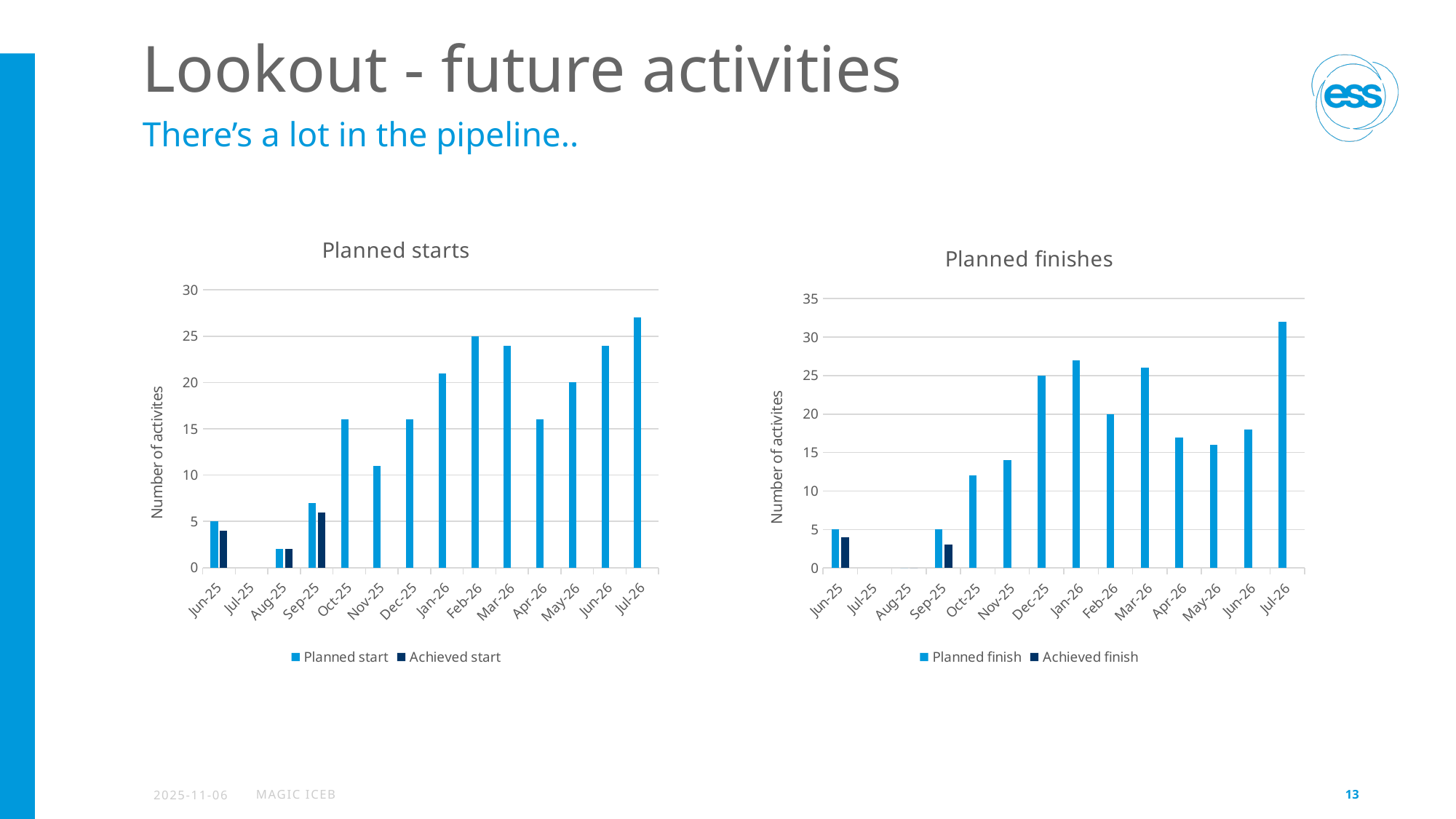
In the Planned finishes chart, which is larger, the Planned finish value for Jan-26 or for Apr-26? Jan-26 In the Planned finishes chart, which month has the highest Planned finish value? Jul-26 In the Planned finishes chart, is the Planned finish value for Jul-26 greater or less than 30? greater In the Planned starts chart, which month has the highest Planned start value? Jul-26 How many months are shown on the x axis of the Planned finishes chart? 14 What kind of chart is the Planned starts chart? bar chart How many series does the legend of the Planned starts chart list? 2 In the Planned starts chart, which is larger, the Planned start value for Feb-26 or for Oct-25? Feb-26 In the Planned finishes chart, is the Planned finish value for Nov-25 greater or less than 15? less In the Planned starts chart, is the Planned start value for Jul-26 greater or less than 25? greater What are the two legend entries of the Planned finishes chart? Planned finish, Achieved finish